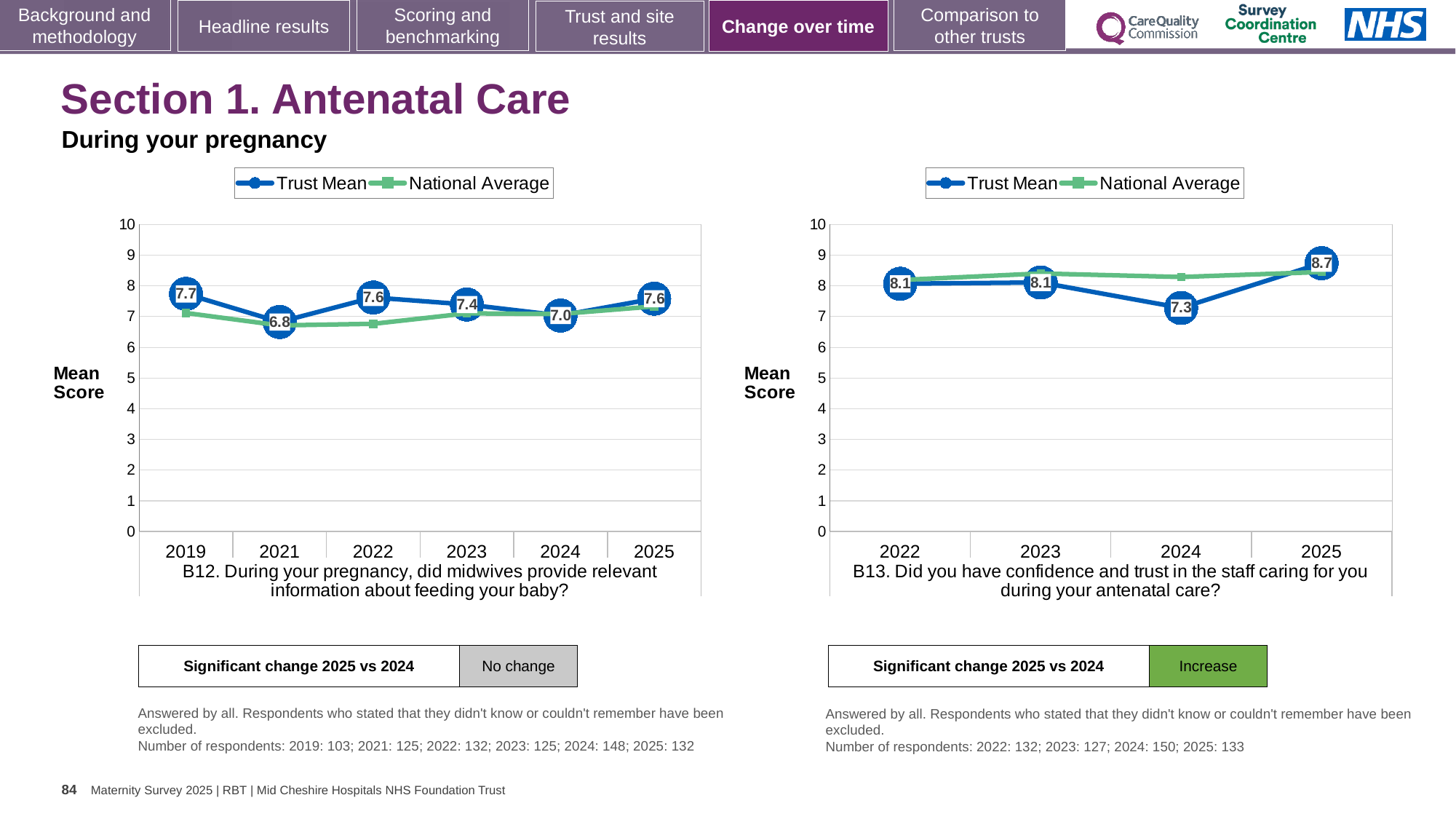
How many years are plotted on the x axis of the B12 chart (left)? 6 In the B13 chart (right), does the Trust Mean rise or fall from 2024 to 2025? Rise In the B12 chart (left), which is larger: the Trust Mean for 2019 or the Trust Mean for 2024? 2019 In the B13 chart (right), what is the Trust Mean for 2024? 7.3 In the B13 chart (right), what is the difference between the Trust Mean for 2025 and the Trust Mean for 2024? 1.4 In the B13 chart (right), which year has the highest Trust Mean? 2025 In the B12 chart (left), what is the Trust Mean for 2021? 6.8 In the B13 chart (right), is the National Average for 2024 greater or less than 7? greater How many series does the legend of the B13 chart (right) list? 2 In the B12 chart (left), what is the Trust Mean for 2025? 7.6 In the B12 chart (left), which year has the lowest Trust Mean? 2021 What kind of chart is the B12 chart (left)? Line chart